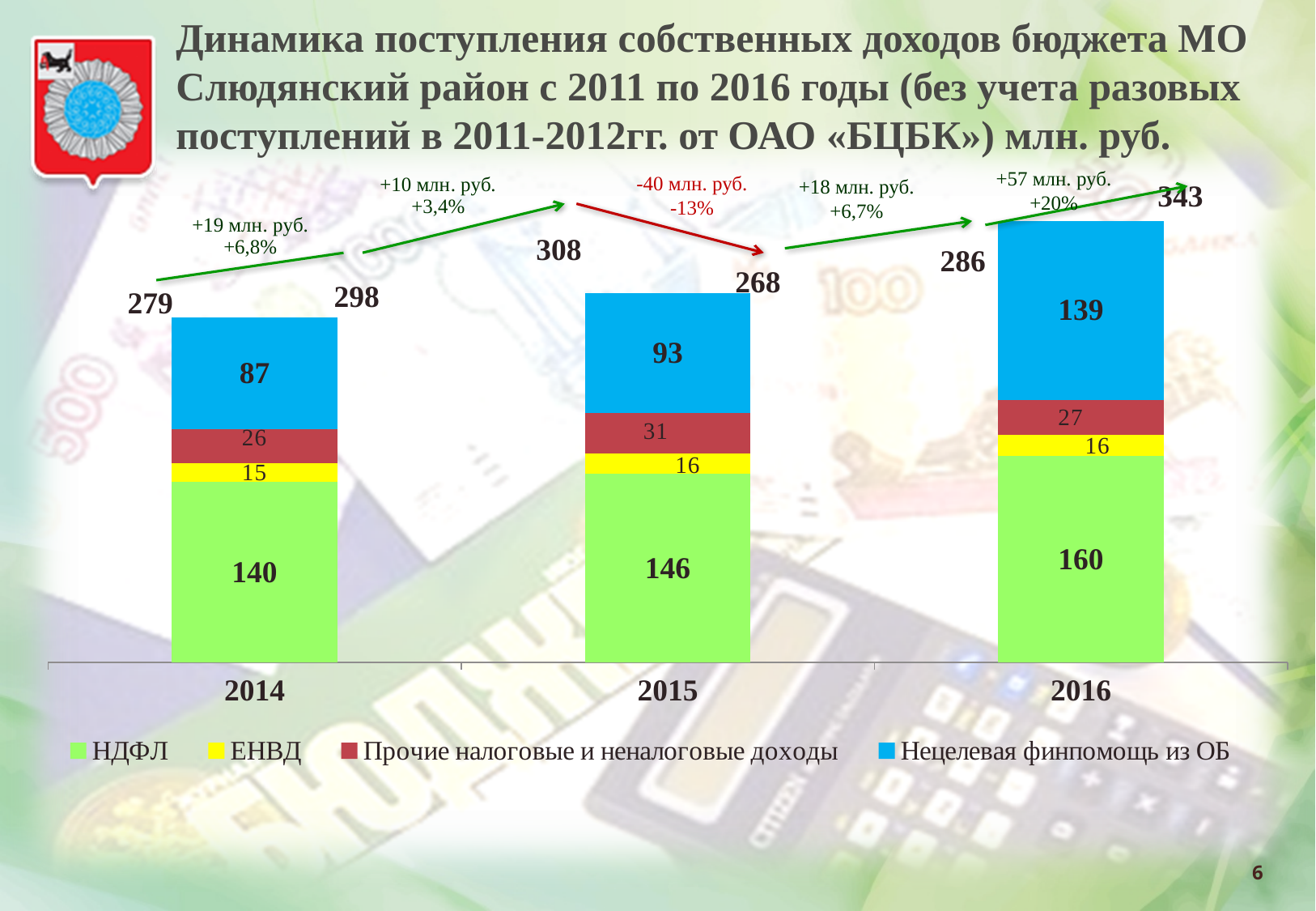
How many series does the legend list? 4 What is the total of the stacked bar for 2014? 268 How many years are shown on the x axis of the chart? 3 What is the value of Нецелевая финпомощь из ОБ for 2015? 93 Does the НДФЛ value rise or fall from 2014 to 2016? Rise What is the difference between the Нецелевая финпомощь из ОБ values for 2016 and 2014? 52 What kind of chart is shown on the slide? Stacked bar chart What is the value of ЕНВД for 2014? 15 What colour represents НДФЛ in the chart? Green In which year is the НДФЛ value the highest? 2016 What is the value of НДФЛ for 2016? 160 Which year has the larger value for Прочие налоговые и неналоговые доходы, 2015 or 2016? 2015